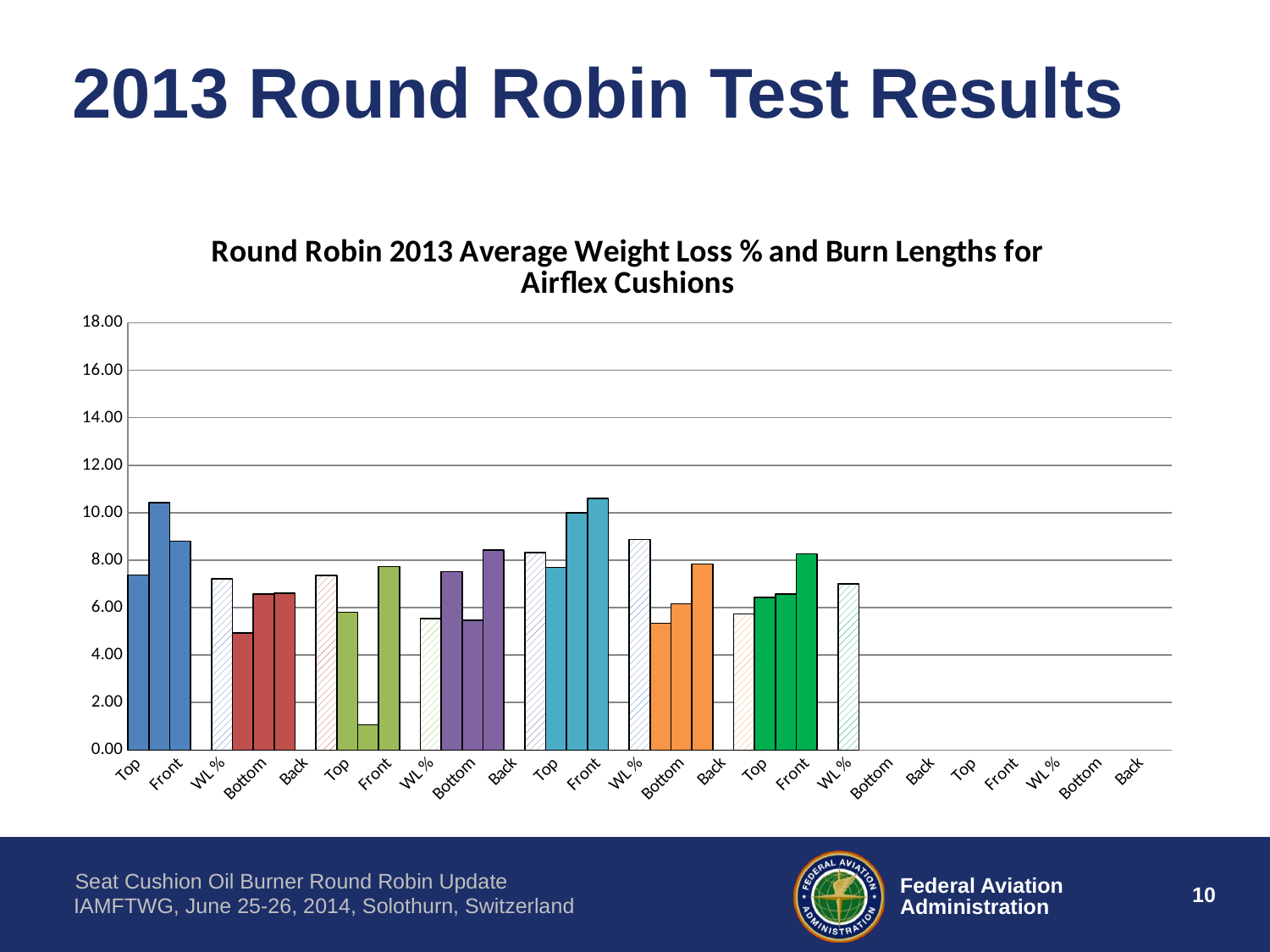
Is the tallest bar on the chart greater or less than 10.00? greater Does any bar on the chart reach the 14.00 gridline? No How many category labels appear along the x axis of the chart? 25 How many distinct colour groups of bars are plotted on the chart? 7 Is the leftmost bar on the chart greater or less than 6.00? greater What kind of chart is shown on the slide? Bar chart What is the title of the chart? Round Robin 2013 Average Weight Loss % and Burn Lengths for Airflex Cushions What is the highest value shown on the chart's vertical axis? 18.00